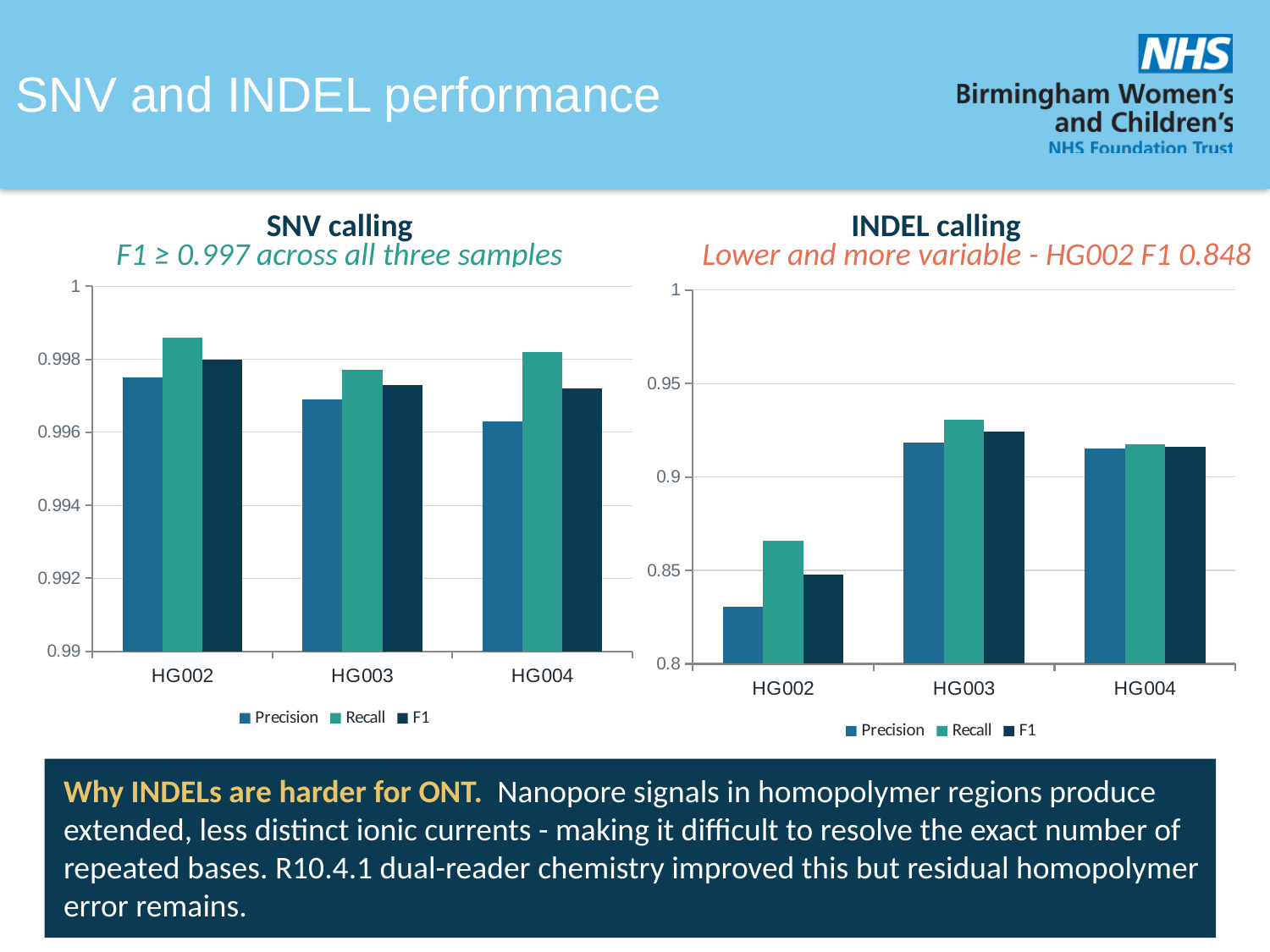
What kind of chart is the SNV calling chart? bar chart How many series does the legend of the SNV calling chart list? 3 In the INDEL calling chart, is the Recall value for HG003 greater or less than 0.9? greater In the INDEL calling chart, is the Precision value for HG002 greater or less than 0.85? less In the SNV calling chart, which sample has the lowest Precision value? HG004 In the SNV calling chart, which sample has the higher Precision: HG002 or HG003? HG002 In the SNV calling chart, is the Recall value for HG002 greater or less than 0.998? greater According to the INDEL calling chart subtitle, what is the F1 value for HG002? 0.848 How many samples are shown on the x axis of the INDEL calling chart? 3 In the INDEL calling chart, which is larger for HG002: Precision or Recall? Recall In the INDEL calling chart, which sample has the lowest F1 value? HG002